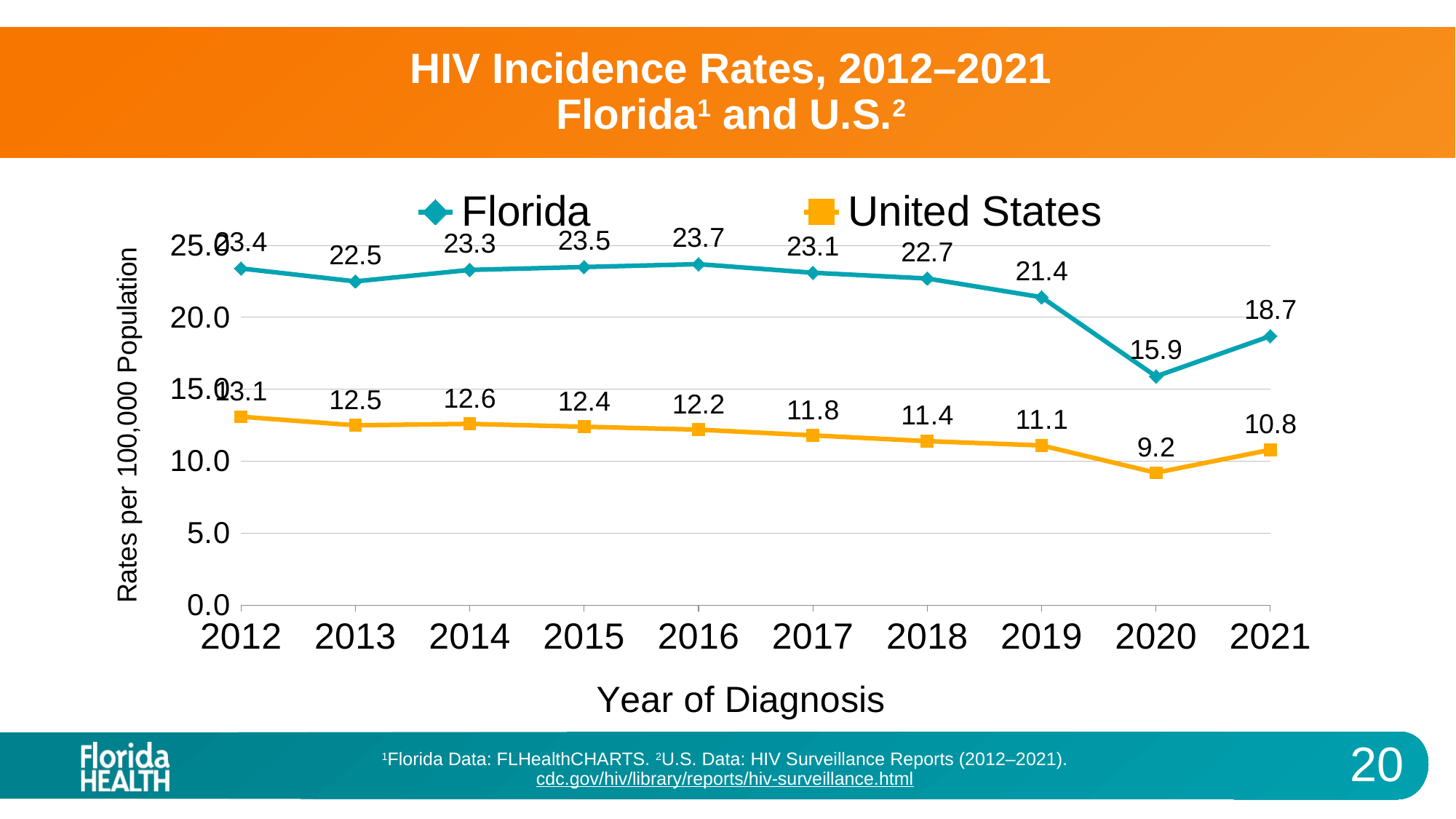
How much higher is the Florida rate in 2021 than in 2020? 2.8 What kind of chart is shown on the slide? line chart How many years are shown on the x axis? 10 In which year is the United States rate lowest? 2020 What is the United States HIV incidence rate for 2020? 9.2 Is the Florida value for 2020 greater or less than 20.0? less In which year is the Florida rate highest? 2016 Which is larger in 2018, the Florida rate or the United States rate? Florida What is the Florida HIV incidence rate for 2016? 23.7 What is the difference between the Florida and United States rates in 2019? 10.3 How many series does the legend list? 2 What is the Florida rate in 2021? 18.7